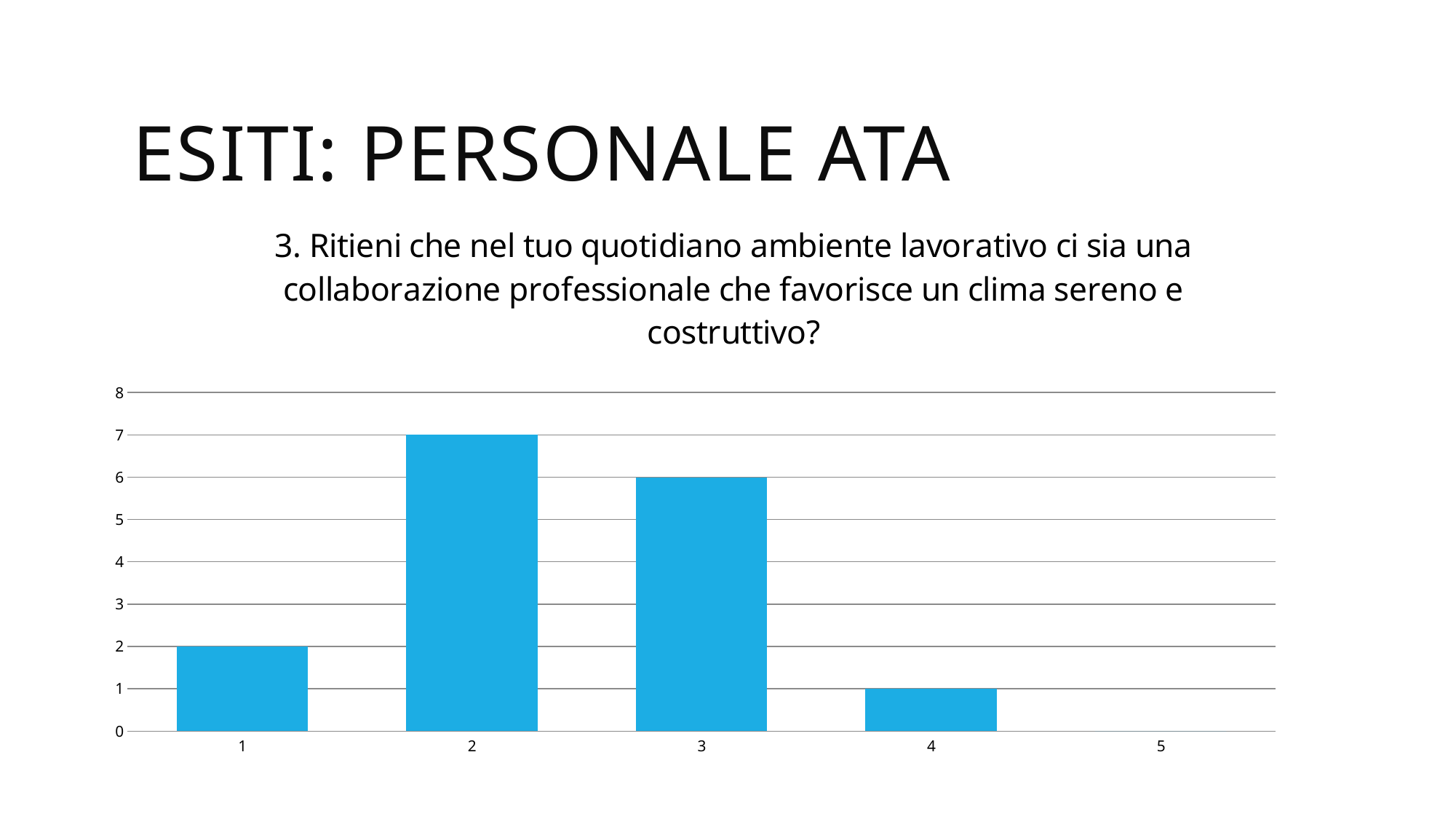
What type of chart is shown on the slide? bar chart What is the value for category 4? 1 What is the value for category 3? 6 How many categories are shown on the x axis? 5 Is the value for category 2 greater or less than 5? greater Which category has the highest value? 2 What is the value for category 2? 7 What is the difference between the values for category 2 and category 3? 1 Which category has the lowest value? 5 Which is larger, the value for category 1 or the value for category 4? category 1 What is the highest value shown on the y axis? 8 What is the value for category 1? 2